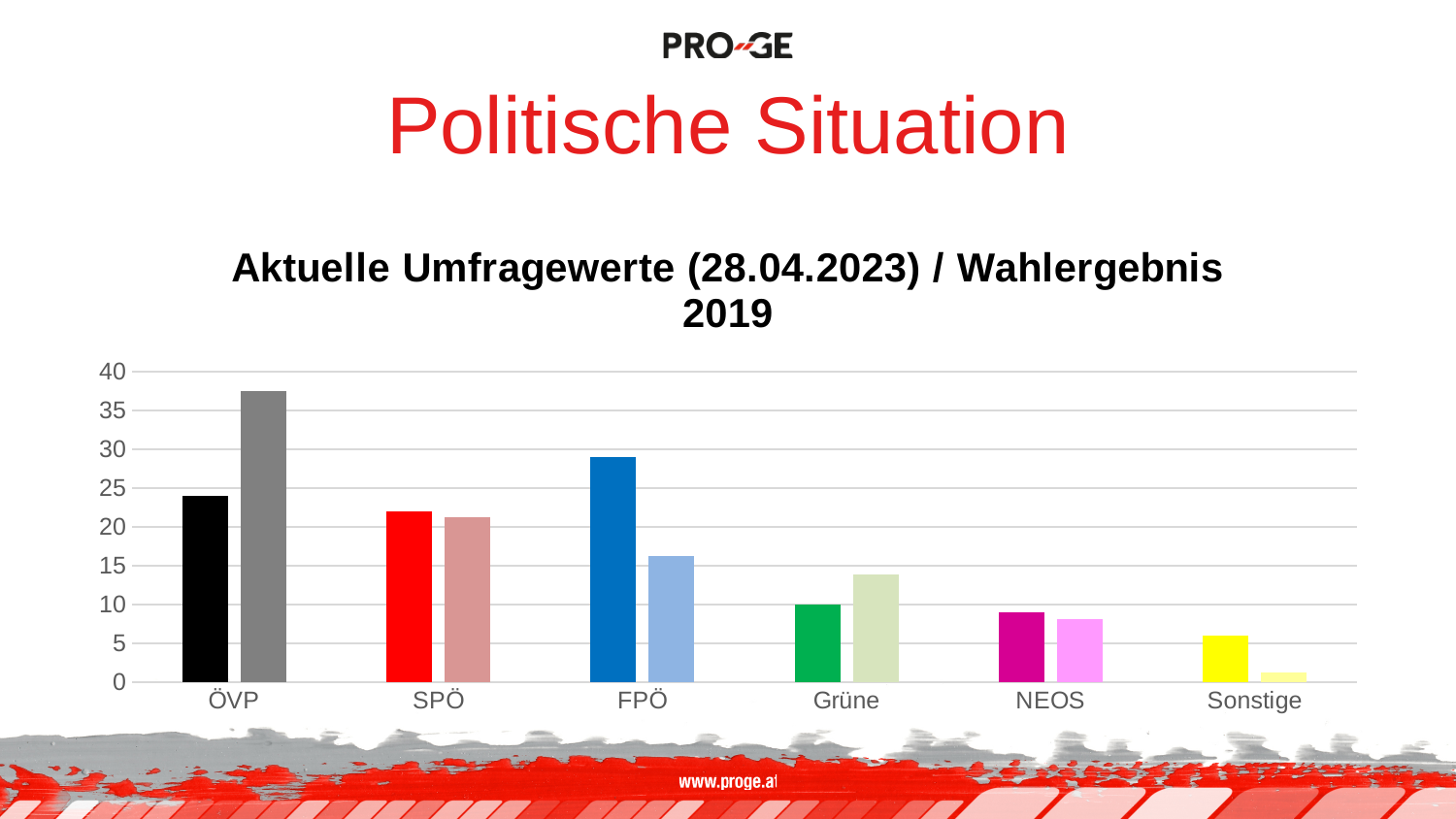
Which category contains the shortest bar in the chart? Sonstige What is the title of the chart? Aktuelle Umfragewerte (28.04.2023) / Wahlergebnis 2019 Which category contains the tallest bar in the chart? ÖVP What kind of chart is shown on the slide? bar chart Which is taller, the right (light red) bar for SPÖ or the right (light blue) bar for FPÖ? the right bar for SPÖ Is the value of the left (black) bar for ÖVP greater or less than 20? greater Is the value of the right (light yellow) bar for Sonstige greater or less than 5? less Is the value of the right (light blue) bar for FPÖ greater or less than 20? less For Grüne, which bar is taller, the left (dark green) bar or the right (light green) bar? the right (light green) bar How many categories (parties) are shown on the x axis of the chart? 6